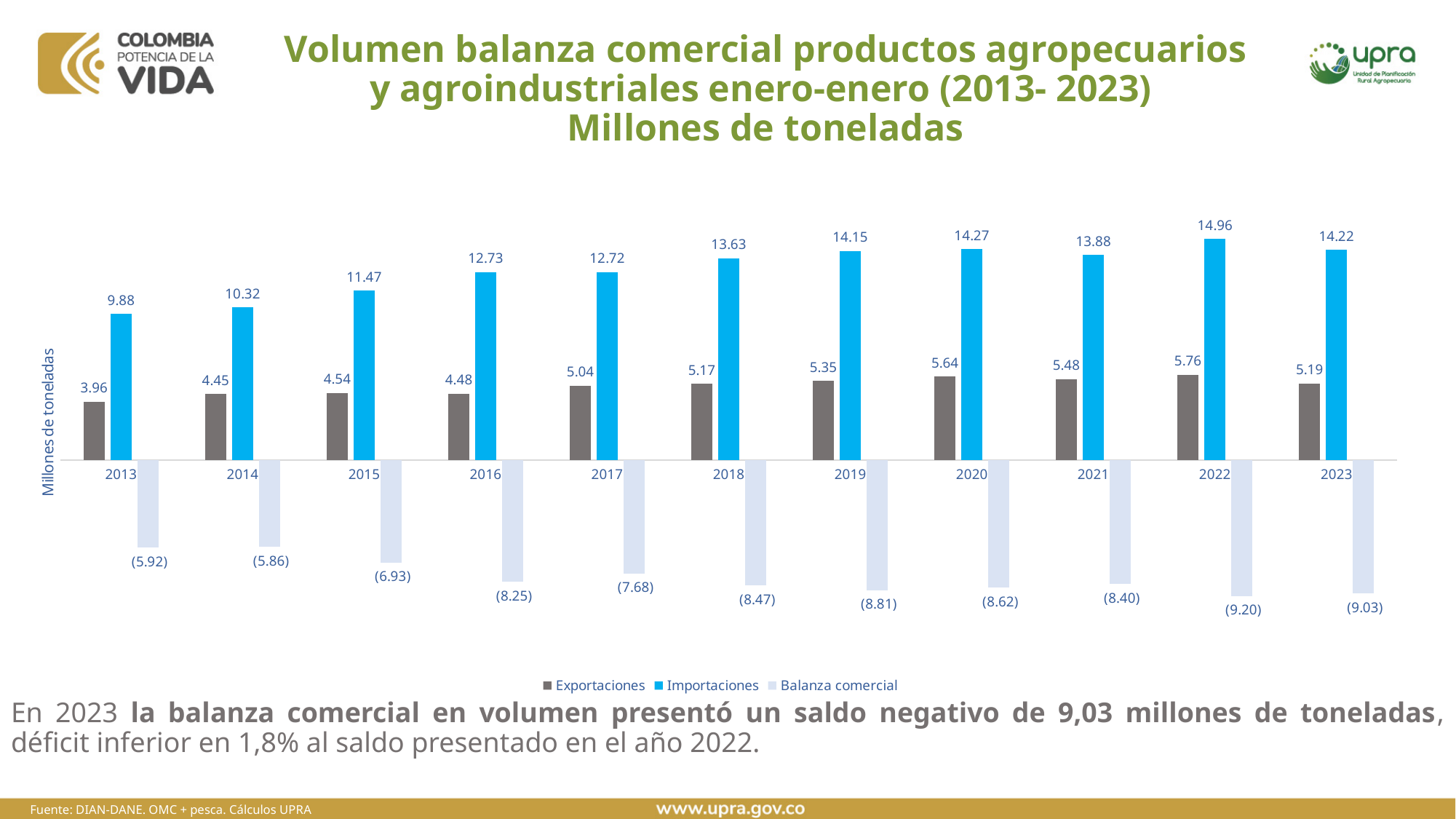
What is the Balanza comercial value shown for 2016? (8.25) In which year is the Exportaciones value lowest? 2013 Which is larger, Exportaciones in 2020 or Exportaciones in 2021? 2020 What is the value of Exportaciones for 2017? 5.04 How many years are shown on the x axis? 11 In which year is the Importaciones value highest? 2022 What is the difference between the Importaciones values for 2022 and 2013? 5.08 How many series does the legend list? 3 Do the Importaciones values generally rise or fall from 2013 to 2023? Rise What kind of chart is shown on the slide? Bar chart What is the value of Importaciones for 2023? 14.22 What is the difference between Importaciones and Exportaciones in 2023? 9.03